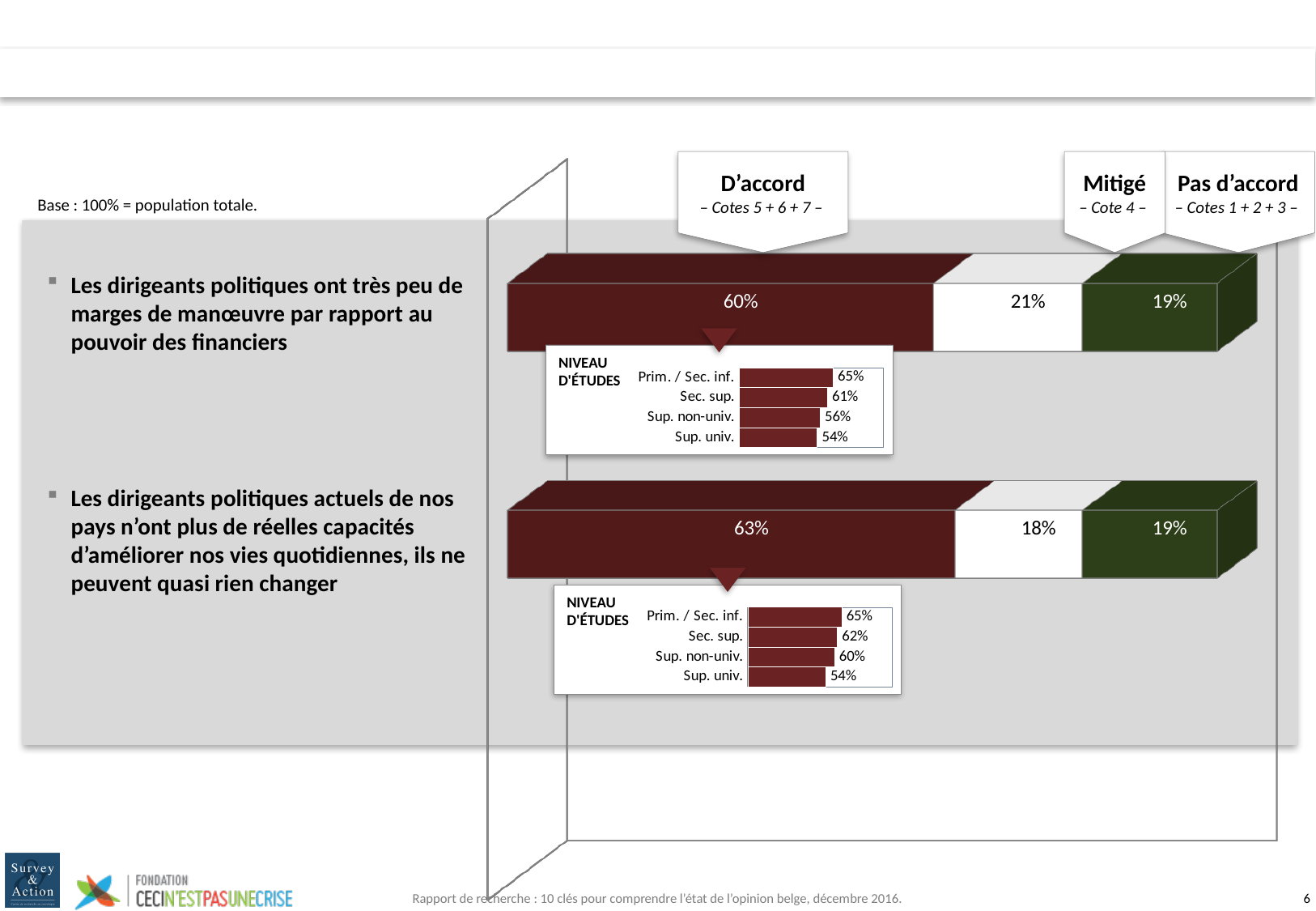
For the statement 'Les dirigeants politiques actuels de nos pays n'ont plus de réelles capacités d'améliorer nos vies quotidiennes', what percentage is 'Pas d'accord'? 19% What is the difference between the 'D'accord' percentages of the second statement (63%) and the first statement (60%)? 3 percentage points How many education levels are shown in each 'Niveau d'études' breakdown? 4 In the 'Niveau d'études' breakdown under the first statement (marges de manœuvre), which education level has the highest value? Prim. / Sec. inf. In the 'Niveau d'études' breakdown under the first statement, what is the difference between 'Prim. / Sec. inf.' and 'Sup. univ.'? 11 percentage points Which is larger: the 'Mitigé' share for the first statement or the 'Mitigé' share for the second statement? The first statement (21%) In the 'Niveau d'études' breakdown under the second statement (capacités d'améliorer nos vies quotidiennes), which education level has the lowest value? Sup. univ. In the 'Niveau d'études' breakdown under the second statement (capacités d'améliorer nos vies quotidiennes), what is the value for 'Sup. non-univ.'? 60% For the statement 'Les dirigeants politiques ont très peu de marges de manœuvre par rapport au pouvoir des financiers', what percentage is 'D'accord'? 60% For the statement 'Les dirigeants politiques actuels de nos pays n'ont plus de réelles capacités d'améliorer nos vies quotidiennes', what percentage is 'D'accord'? 63% In the 'Niveau d'études' breakdown under the first statement (marges de manœuvre), what is the value for 'Sup. univ.'? 54% For the statement 'Les dirigeants politiques ont très peu de marges de manœuvre par rapport au pouvoir des financiers', what percentage is 'Mitigé'? 21%